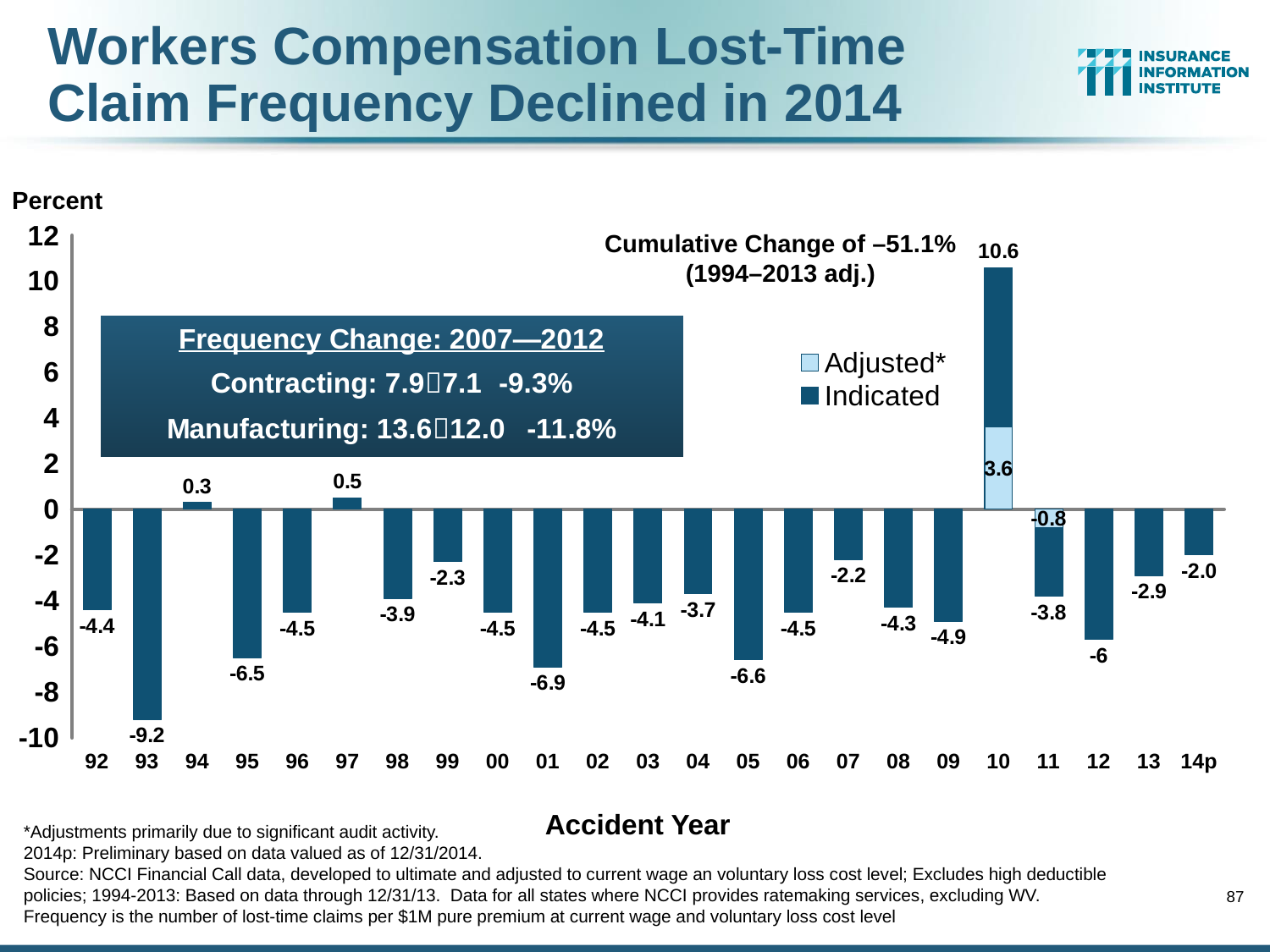
What is the Adjusted value for accident year 10? 3.6 Which is larger, the value for accident year 97 or accident year 94? 97 What is the value for accident year 93? -9.2 Which accident year has the highest value? 10 What is the value for accident year 14p? -2.0 Which accident year has the lowest value? 93 What kind of chart is this? Bar chart What is the x-axis title of the chart? Accident Year What is the difference between the values for accident years 12 and 13? 3.1 How many accident years are shown on the x axis? 23 How many series does the legend list? 2 What is the Indicated value for accident year 10? 10.6